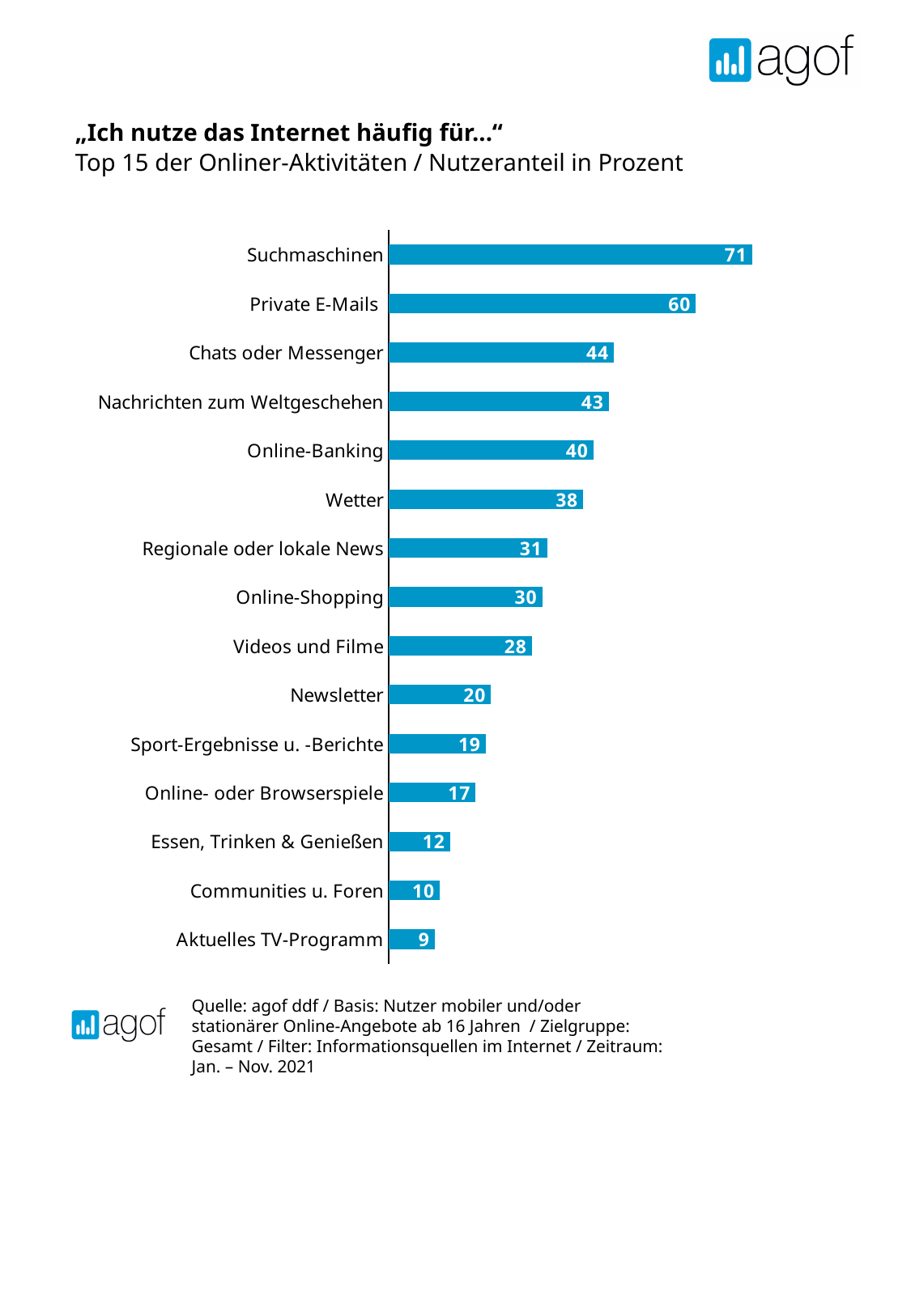
What is the value for Suchmaschinen? 71 What is the value for Online-Banking? 40 What is the value for Newsletter? 20 Which is larger, the value for Online-Shopping or the value for Regionale oder lokale News? Regionale oder lokale News Which category has the lowest value? Aktuelles TV-Programm What is the title of the chart? „Ich nutze das Internet häufig für...“ What kind of chart is shown on the slide? Bar chart What is the difference between the values for Wetter and Videos und Filme? 10 What is the difference between the values for Suchmaschinen and Private E-Mails? 11 How many categories are shown in the chart? 15 Which is larger, the value for Essen, Trinken & Genießen or the value for Online- oder Browserspiele? Online- oder Browserspiele Which category has the highest value? Suchmaschinen